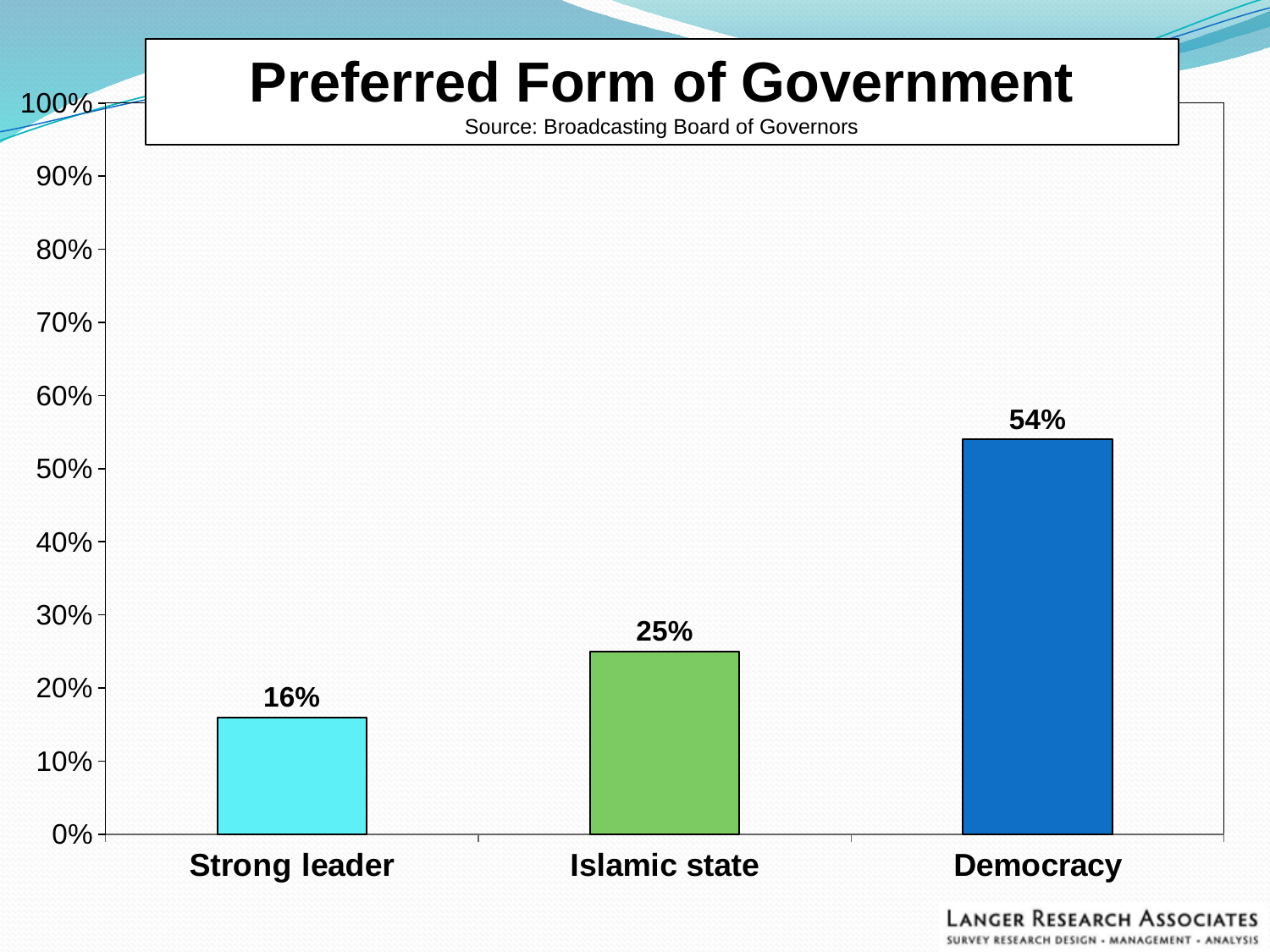
Which is larger, the value for Islamic state or the value for Strong leader? Islamic state Which category has the highest value? Democracy What is the value for Democracy? 54% Is the value for Democracy greater or less than 50%? greater What is the title of the chart? Preferred Form of Government What is the difference between the values for Democracy and Islamic state? 29% What is the value for Strong leader? 16% Which category has the lowest value? Strong leader What kind of chart is shown on the slide? bar chart What is the value for Islamic state? 25% How many categories are shown on the chart? 3 What is the difference between the values for Islamic state and Strong leader? 9%